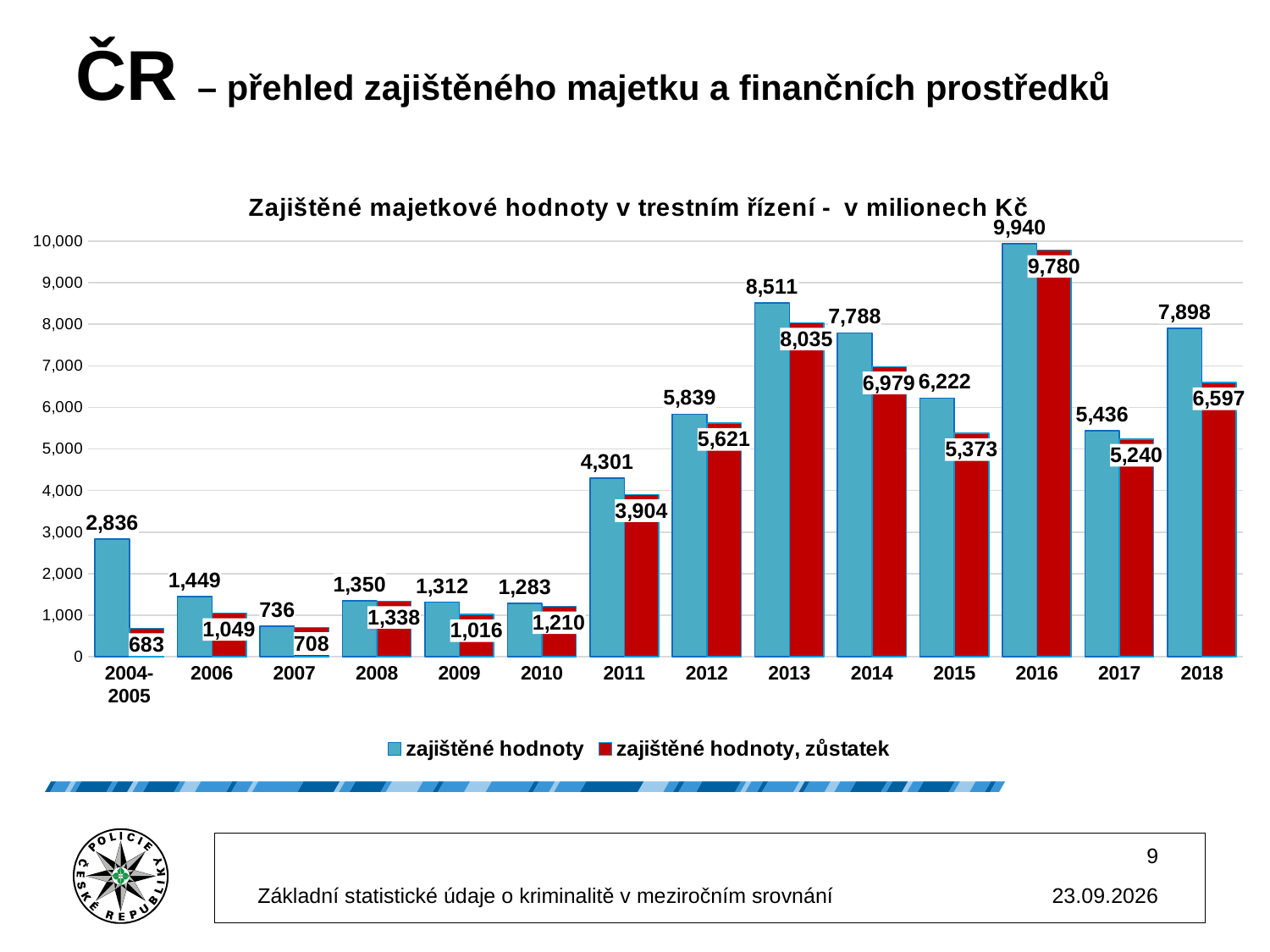
What is the value of 'zajištěné hodnoty, zůstatek' for 2011? 3,904 Which year has the highest value of 'zajištěné hodnoty'? 2016 How many series does the legend list? 2 What is the difference between 'zajištěné hodnoty' and 'zajištěné hodnoty, zůstatek' in 2016? 160 What is the value of 'zajištěné hodnoty' for 2013? 8,511 How many year categories are shown on the x axis? 14 Which year has the lowest value of 'zajištěné hodnoty'? 2007 Which year has the larger value of 'zajištěné hodnoty': 2014 or 2018? 2018 Is the value of 'zajištěné hodnoty' for 2012 greater or less than 5,000? greater Do the values of 'zajištěné hodnoty' rise or fall from 2011 to 2013? rise What kind of chart is shown on the slide? bar chart What is the difference between 'zajištěné hodnoty' and 'zajištěné hodnoty, zůstatek' in 2018? 1,301